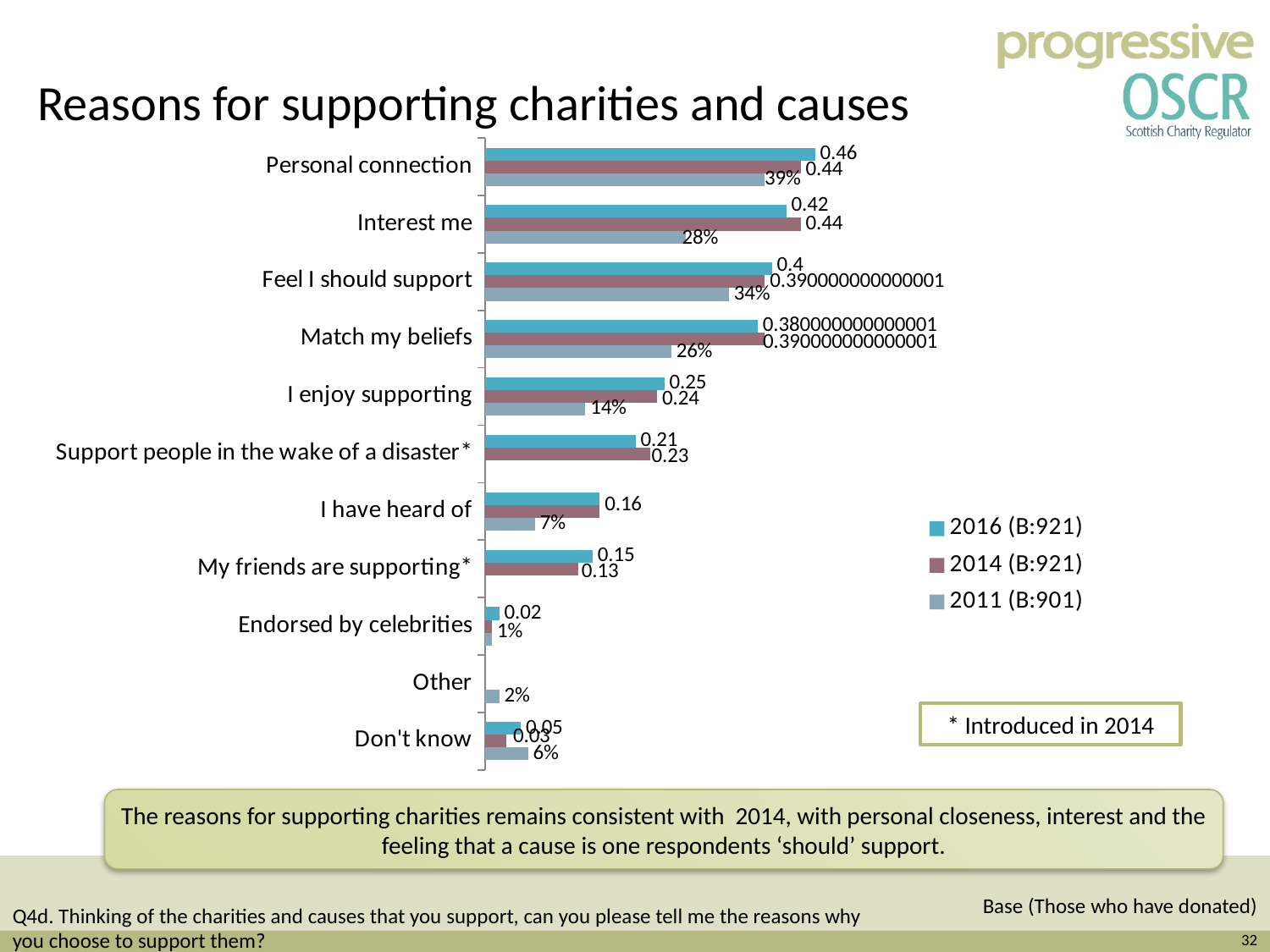
What is the 2014 value for Support people in the wake of a disaster*? 0.23 How many series does the legend list? 3 Which category has the lowest 2011 value? Endorsed by celebrities What is the 2016 value for Don't know? 0.05 What is the 2011 value for I enjoy supporting? 14% What kind of chart is shown on the slide? Bar chart What is the 2016 value for Personal connection? 0.46 Which category has the highest 2016 value? Personal connection What is the 2011 value for Interest me? 28% For Interest me, which is larger: the 2016 value or the 2014 value? 2014 What is the difference between the 2016 and 2014 values for Personal connection? 0.02 How many categories are shown on the chart? 11